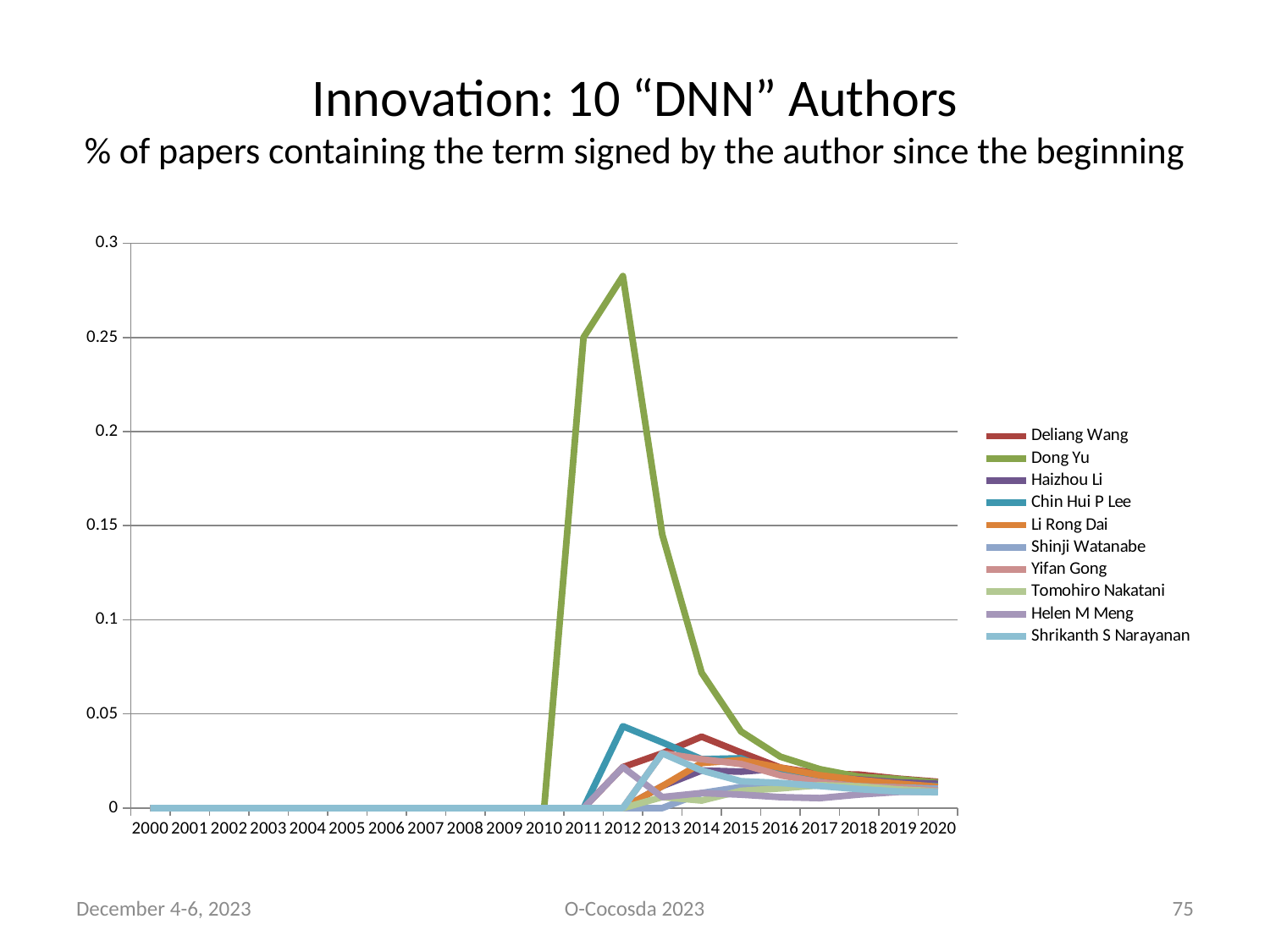
How many series does the legend list? 10 What kind of chart is shown on the slide? line chart Which author's line reaches the highest value on the chart? Dong Yu Is the value for Dong Yu in 2012 greater or less than 0.25? greater Is the value for Dong Yu in 2011 greater or less than 0.2? greater Is the value for Dong Yu in 2014 greater or less than 0.1? less In which year does the Dong Yu line reach its peak? 2012 How many years are shown along the x axis? 21 What is the title of the slide's chart? Innovation: 10 "DNN" Authors Does the Dong Yu line rise or fall from 2012 to 2020? fall What is the value for Dong Yu in 2005? 0